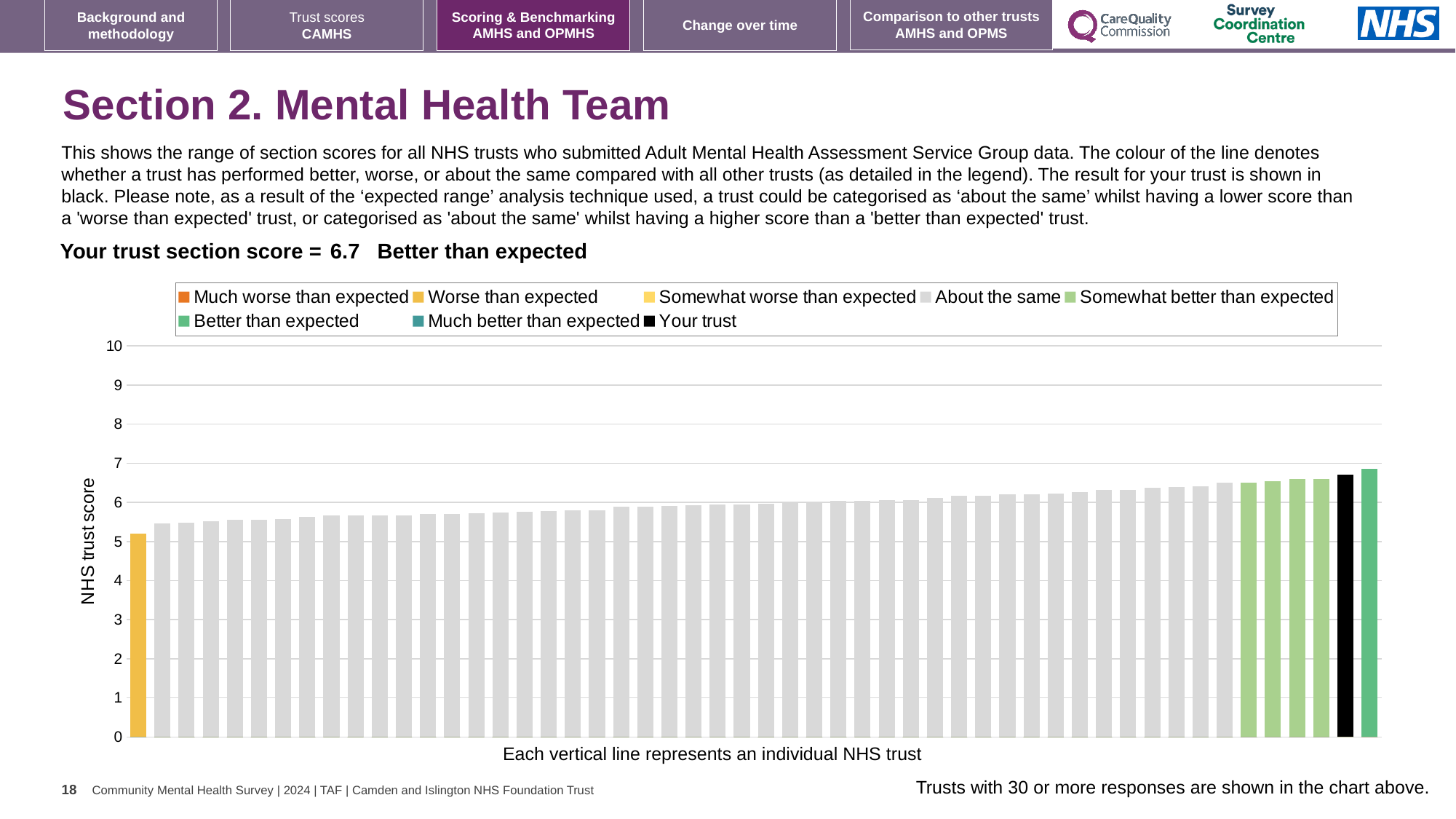
Do the bar values rise or fall from left to right along the x axis? rise What is the title of the vertical axis? NHS trust score Which is higher: the leftmost yellow bar or the black bar (your trust)? the black bar (your trust) Which is higher: the black bar (your trust) or the rightmost teal bar? the rightmost teal bar Is the value of the leftmost (yellow) bar greater or less than 6? less How many entries does the chart legend list? 8 Is the value of the black bar (your trust) greater or less than 6? greater Is the value of the rightmost bar greater or less than 7? less What kind of chart is shown on the slide? bar chart How is your trust's section score categorised compared with other trusts? Better than expected What colour is used for the bar representing your trust? black What is your trust's section score for Section 2. Mental Health Team? 6.7